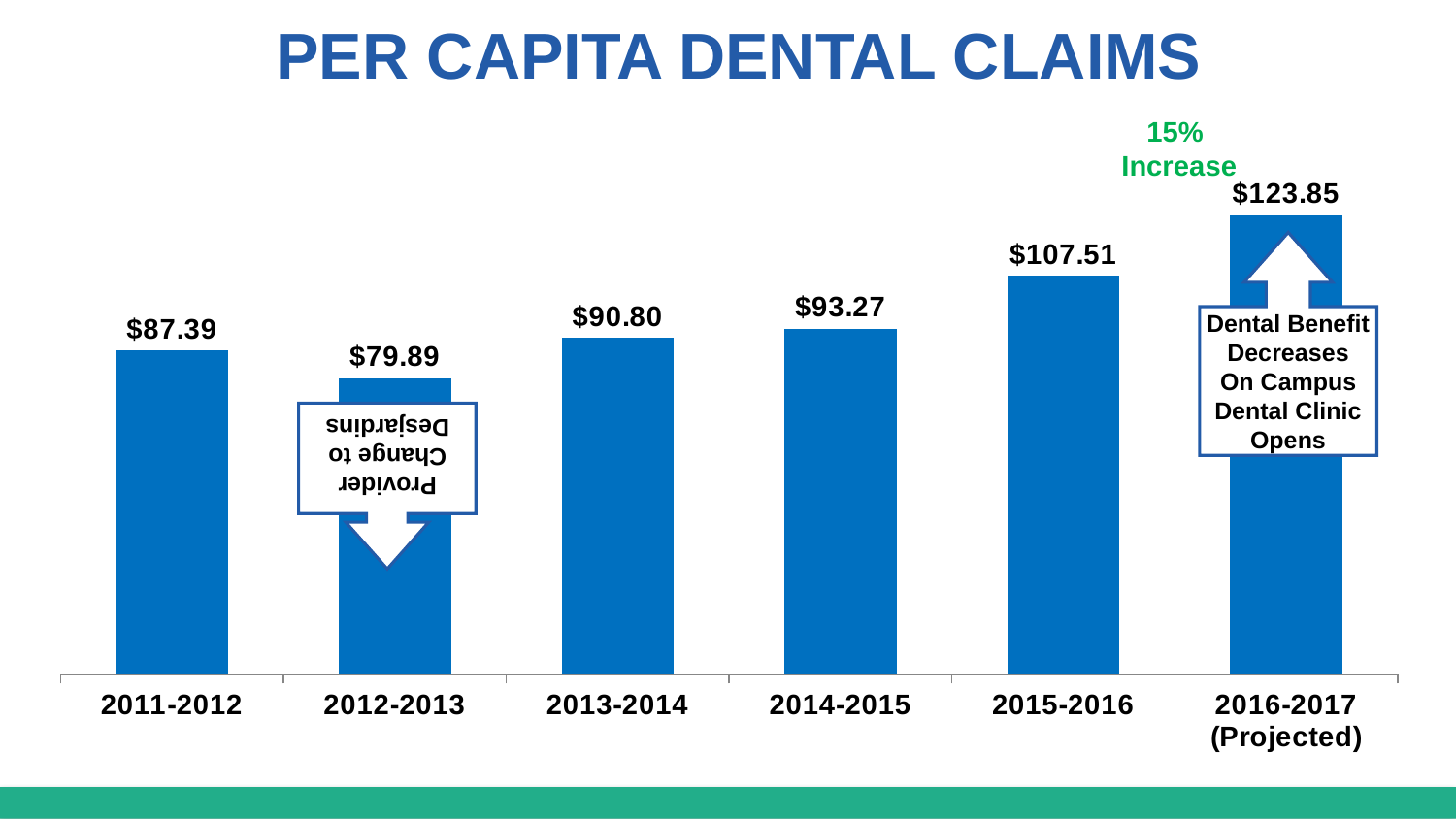
What is the difference between the 2011-2012 value and the 2012-2013 value? $7.50 How many years are shown on the chart? 6 What kind of chart is shown on the slide? Bar chart What is the difference between the 2016-2017 (Projected) value and the 2015-2016 value? $16.34 What is the projected per capita dental claims value for 2016-2017? $123.85 Which year has the highest per capita dental claims? 2016-2017 (Projected) What is the per capita dental claims value for 2012-2013? $79.89 Do the values rise or fall from 2012-2013 through 2016-2017 (Projected)? Rise Which year has the lowest per capita dental claims? 2012-2013 What is the per capita dental claims value for 2011-2012? $87.39 Which is larger, the value for 2013-2014 or the value for 2014-2015? 2014-2015 What is the per capita dental claims value for 2015-2016? $107.51